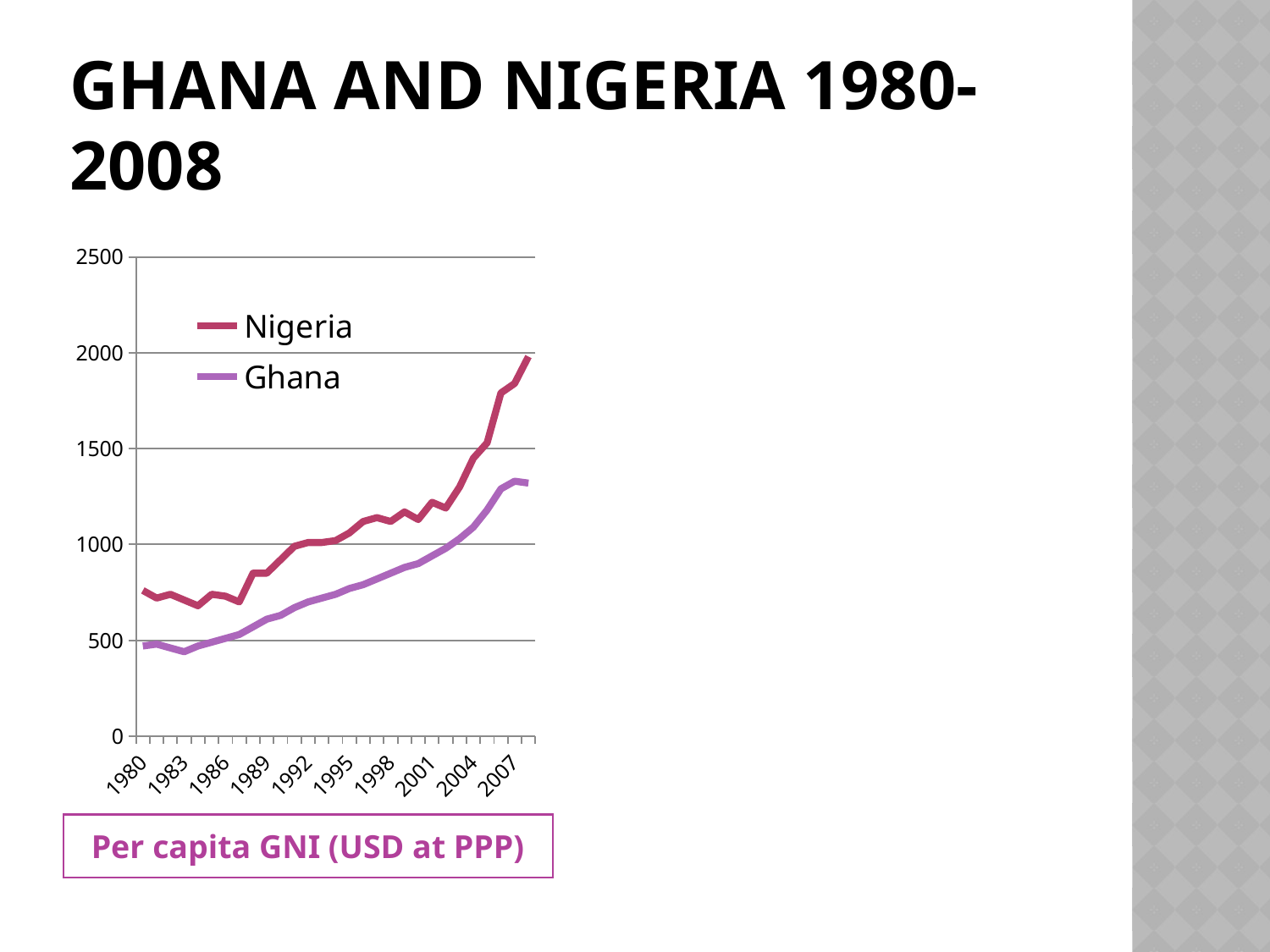
What kind of chart is shown on the slide? line chart Is the value for Nigeria in 2007 greater or less than 1500? greater Do the values for Nigeria generally rise or fall from 1980 to 2008? rise Is the value for Ghana in 1995 greater or less than 1000? less How many series does the legend list? 2 In 1980, which series has the higher value, Nigeria or Ghana? Nigeria Is the value for Ghana in 1983 greater or less than 500? less Which two series are shown in the legend? Nigeria and Ghana In 2007, which series has the higher value, Nigeria or Ghana? Nigeria Do the values for Ghana generally rise or fall from 1980 to 2008? rise What does the caption below the chart say the values represent? Per capita GNI (USD at PPP)